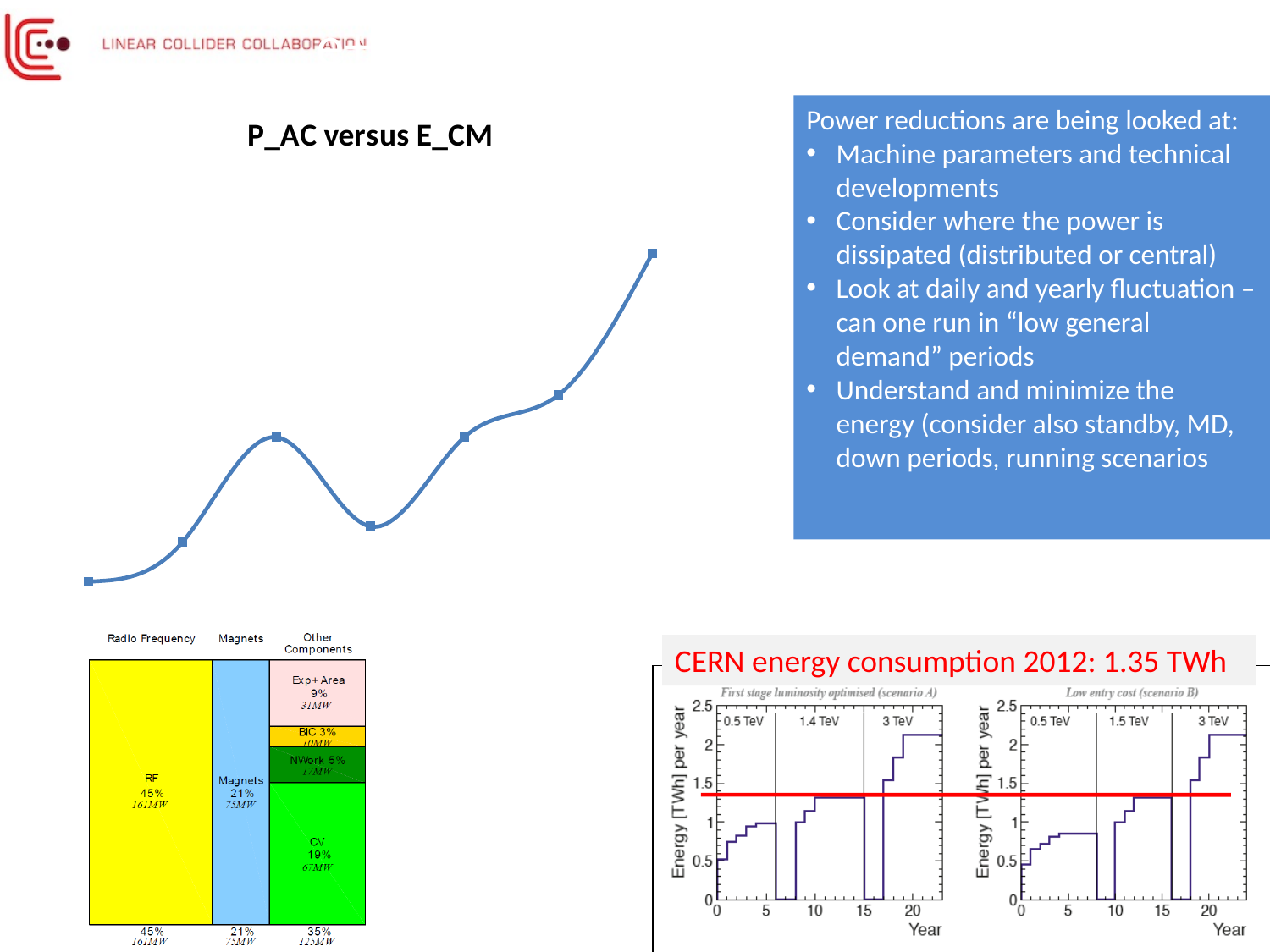
In the 'First stage luminosity optimised (scenario A)' chart at the bottom right, is the energy per year at year 20 greater or less than 1.5? greater How many data points are plotted on the 'P_AC versus E_CM' line chart? 7 On the 'P_AC versus E_CM' chart, does the line overall rise or fall from left to right? rise In the power breakdown chart at the bottom left, what is the difference in MW between RF and Magnets? 86MW In the power breakdown chart at the bottom left, what percentage is attributed to RF? 45% In the power breakdown chart at the bottom left, what is the total percentage for Other Components? 35% In the power breakdown chart at the bottom left, what percentage is attributed to CV? 19% In the power breakdown chart at the bottom left, what is the power in MW for Magnets? 75MW In the power breakdown chart at the bottom left, which is larger, the share for Magnets or the share for CV? Magnets In the power breakdown chart at the bottom left, which of the three main categories (Radio Frequency, Magnets, Other Components) has the largest share? Radio Frequency What kind of chart is the 'P_AC versus E_CM' chart? line chart In the power breakdown chart at the bottom left, which of the Other Components has the smallest share? BIC